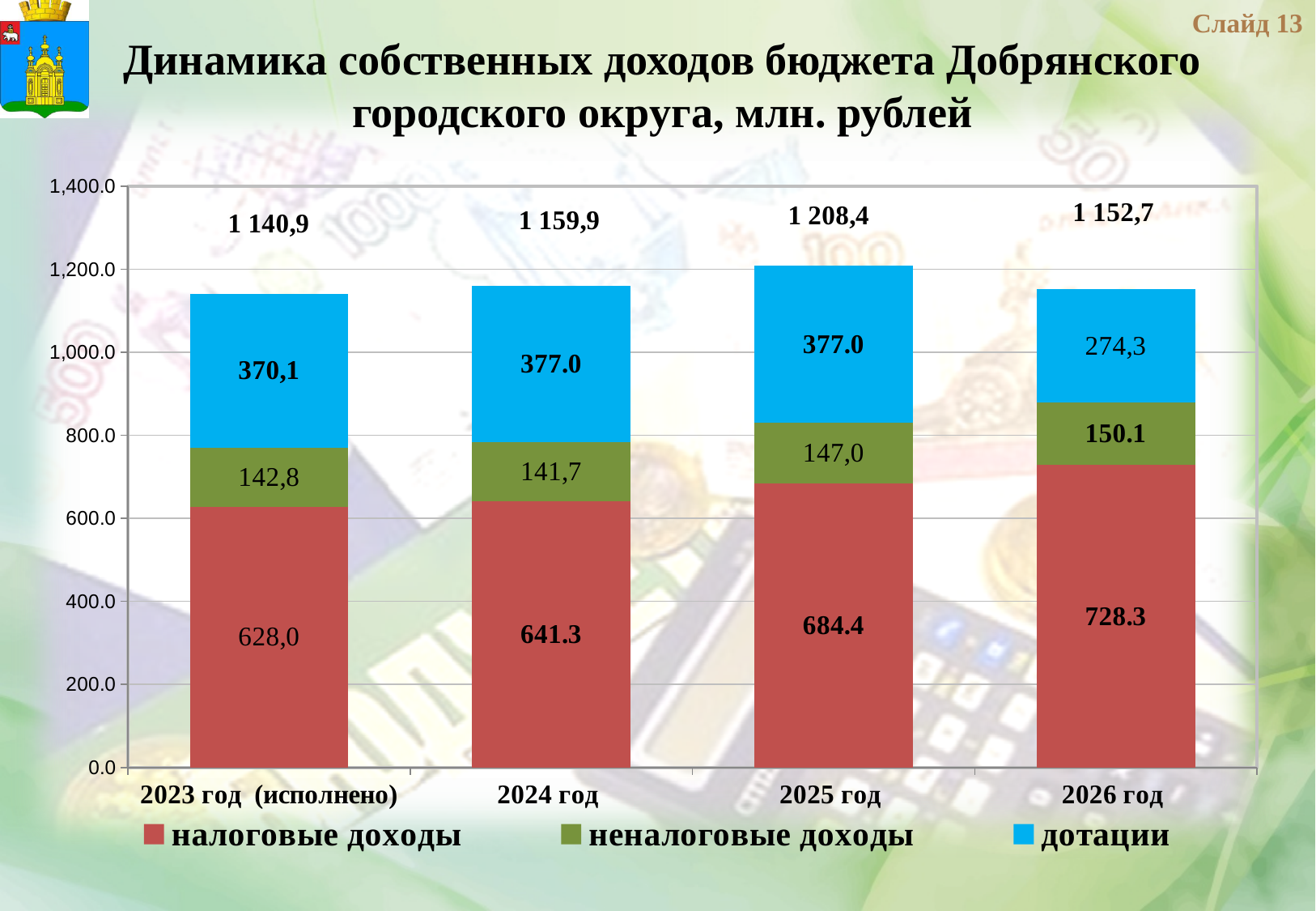
What is the difference between налоговые доходы in 2025 год and 2024 год? 43.1 What is the total of the stacked bar for 2024 год? 1 159,9 How many series does the legend list? 3 What is the value of дотации for 2023 год (исполнено)? 370,1 Which is larger: дотации in 2024 год or дотации in 2026 год? 2024 год Which year has the lowest value for дотации? 2026 год What is the value of неналоговые доходы for 2025 год? 147,0 Do the values for налоговые доходы rise or fall from 2023 год to 2026 год? rise Which year has the highest total shown above its bar? 2025 год What kind of chart is shown on the slide? stacked bar chart What is the value of налоговые доходы for 2026 год? 728.3 How many years (categories) are shown on the x axis? 4